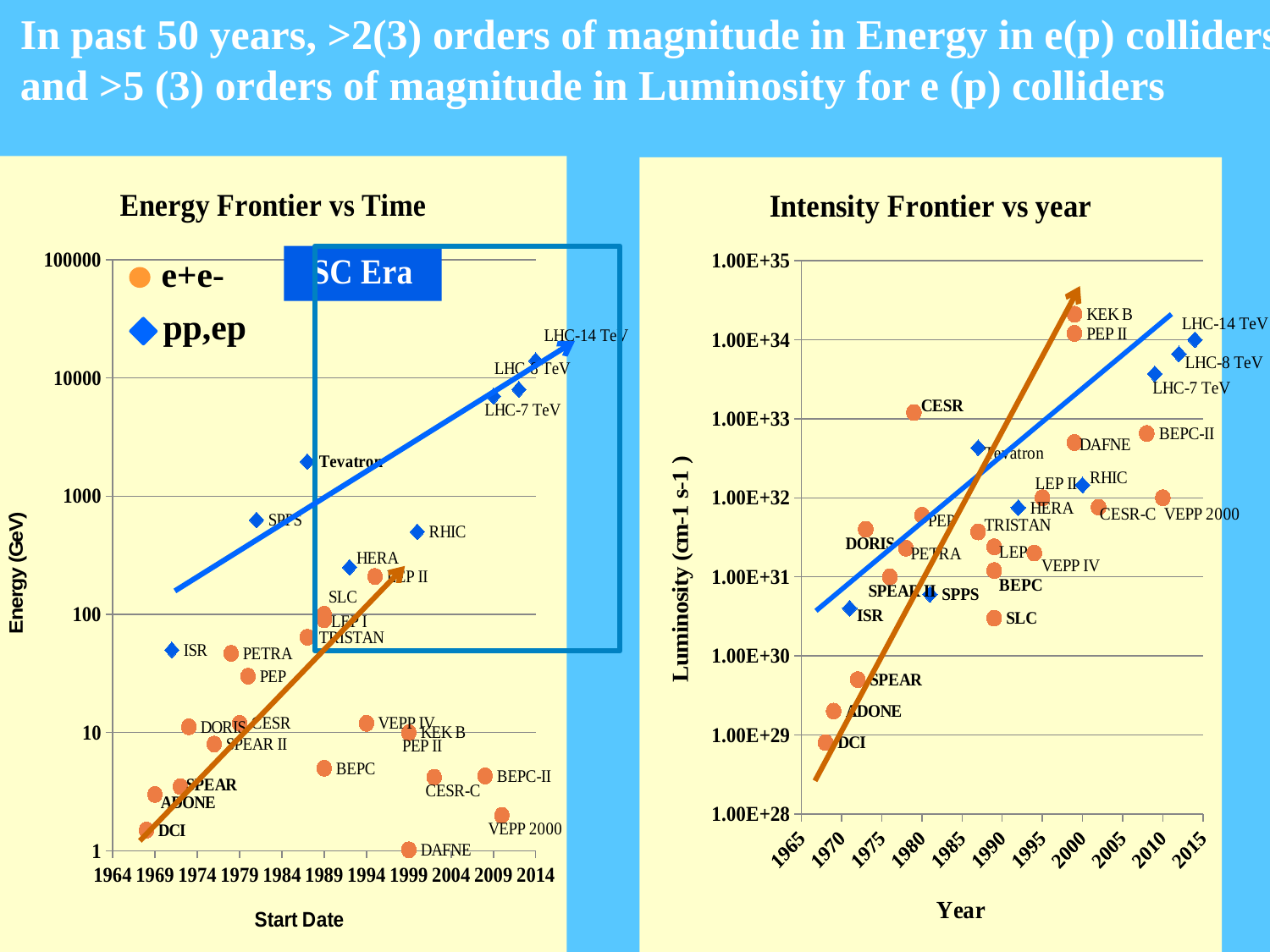
In the "Intensity Frontier vs year" chart, which collider has the highest luminosity? KEK B In the "Energy Frontier vs Time" chart, is the energy for ISR greater or less than 100 GeV? less In the "Intensity Frontier vs year" chart, which has the higher luminosity, CESR or Tevatron? CESR In the "Energy Frontier vs Time" chart, which has the higher energy, Tevatron or RHIC? Tevatron In the "Energy Frontier vs Time" chart, how many series does the legend list? 2 In the "Energy Frontier vs Time" chart, what is the x-axis title? Start Date In the "Energy Frontier vs Time" chart, is the energy for Tevatron greater or less than 1000 GeV? greater In the "Intensity Frontier vs year" chart, which collider has the lowest luminosity? DCI In the "Intensity Frontier vs year" chart, do luminosity values generally rise or fall as the year increases? rise What kind of chart is the "Energy Frontier vs Time" chart? scatter chart In the "Energy Frontier vs Time" chart, which collider has the highest energy? LHC-14 TeV In the "Intensity Frontier vs year" chart, is the luminosity for SLC greater or less than 1.00E+31? less